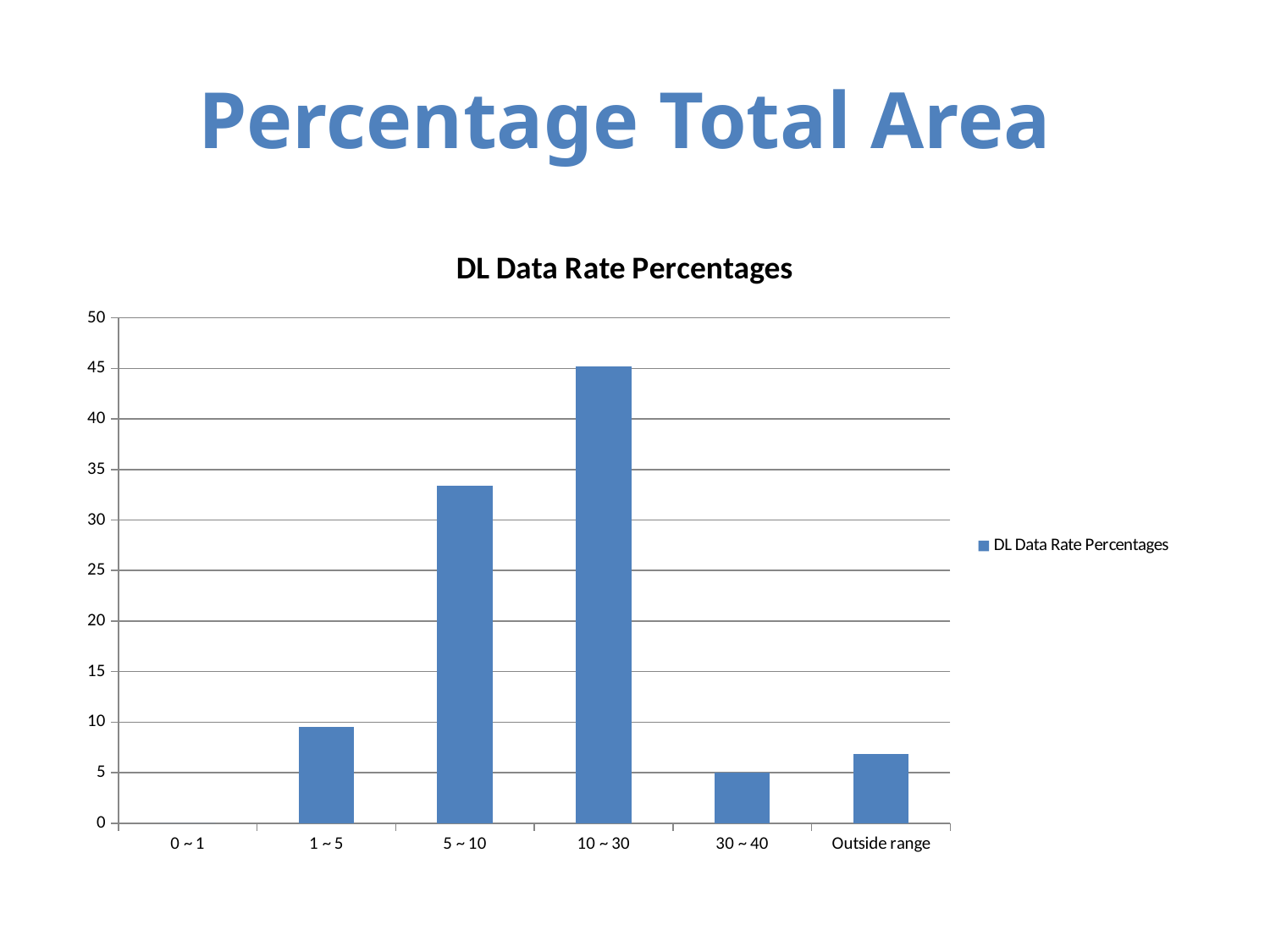
Which has a larger value, 5 ~ 10 or 1 ~ 5? 5 ~ 10 Is the value for 5 ~ 10 greater or less than 30? greater Which category has the lowest value? 0 ~ 1 What is the title of the chart? DL Data Rate Percentages Is the value for 10 ~ 30 greater or less than 40? greater Which has a larger value, 30 ~ 40 or Outside range? Outside range How many series does the legend list? 1 What type of chart is shown on the slide? bar chart Is the value for Outside range greater or less than 5? greater Which category has the highest value? 10 ~ 30 How many categories are shown on the x axis of the chart? 6